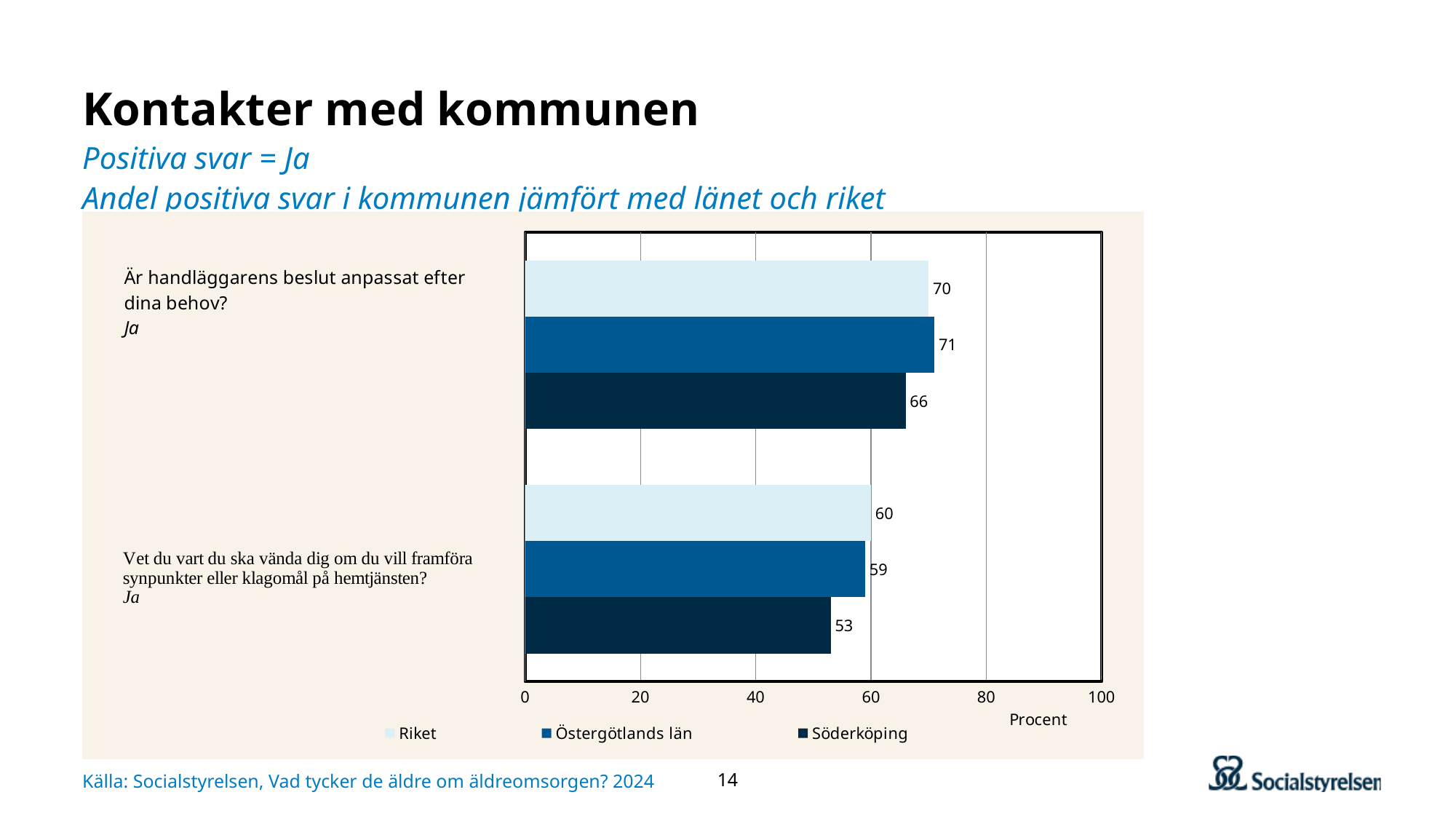
Which series has the highest value on the question "Är handläggarens beslut anpassat efter dina behov?"? Östergötlands län How many series does the legend list? 3 What is the difference between Riket and Söderköping on the question "Vet du vart du ska vända dig om du vill framföra synpunkter eller klagomål på hemtjänsten?"? 7 What is the value for Östergötlands län on the question "Är handläggarens beslut anpassat efter dina behov?"? 71 Is the value for Söderköping on "Vet du vart du ska vända dig om du vill framföra synpunkter eller klagomål på hemtjänsten?" greater or less than 60? less What is the value for Söderköping on the question "Är handläggarens beslut anpassat efter dina behov?"? 66 Which series has the lowest value on the question "Vet du vart du ska vända dig om du vill framföra synpunkter eller klagomål på hemtjänsten?"? Söderköping Is the value for Söderköping on "Är handläggarens beslut anpassat efter dina behov?" larger or smaller than the value for Söderköping on "Vet du vart du ska vända dig om du vill framföra synpunkter eller klagomål på hemtjänsten?"? larger What is the difference between Östergötlands län and Söderköping on the question "Är handläggarens beslut anpassat efter dina behov?"? 5 What is the label of the x axis? Procent What kind of chart is shown on the slide? Bar chart What is the value for Riket on the question "Vet du vart du ska vända dig om du vill framföra synpunkter eller klagomål på hemtjänsten?"? 60